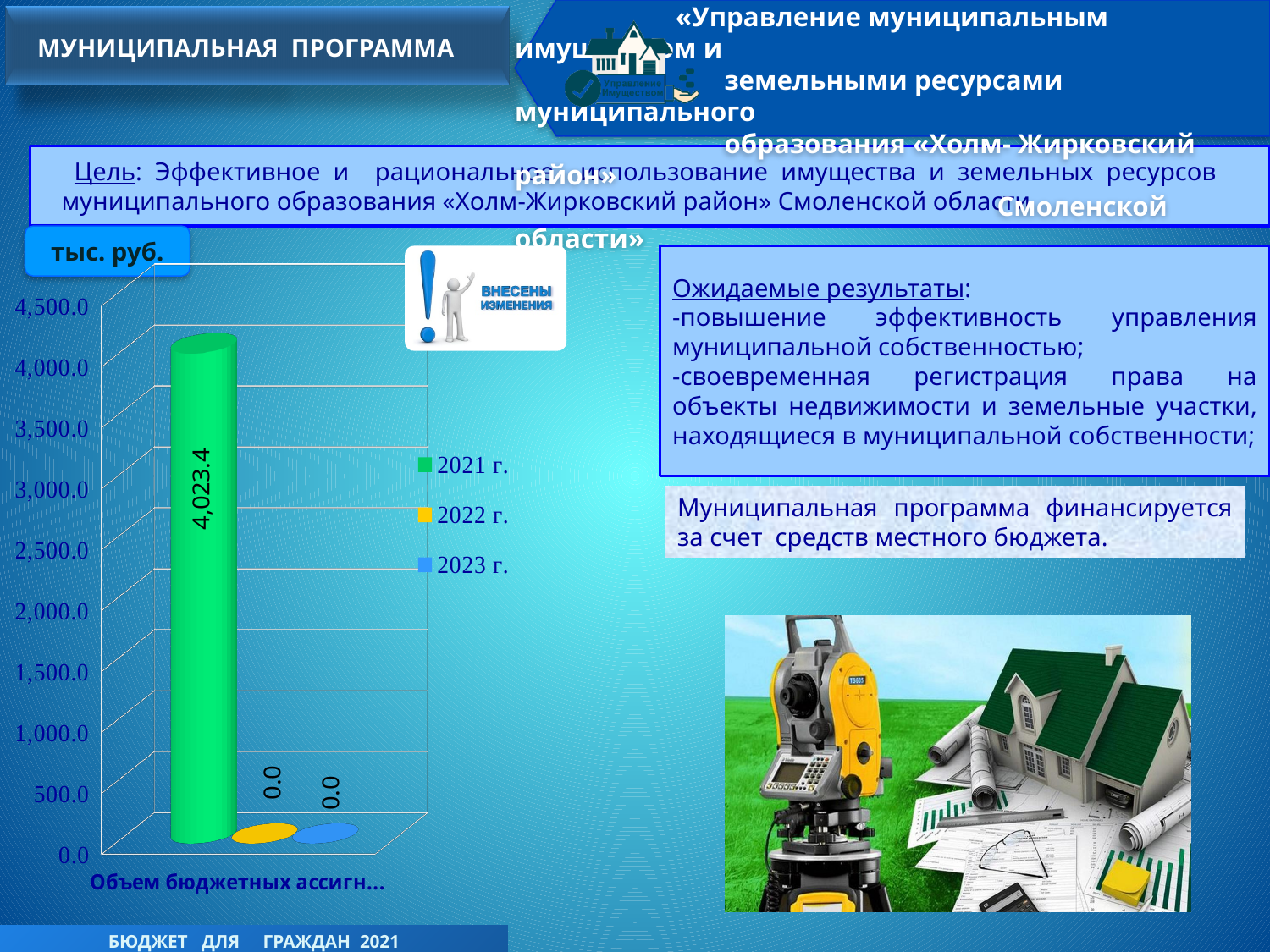
How many series does the chart legend list? 3 What is the highest value shown on the vertical axis of the chart? 4,500.0 What kind of chart is shown on the slide? bar chart What is the value for 2021 г. on the chart? 4,023.4 What is the value for 2022 г. on the chart? 0.0 Which is larger, the value for 2021 г. or the value for 2023 г.? 2021 г. What colour is the bar for 2021 г.? green What is the value for 2023 г. on the chart? 0.0 What is the difference between the values for 2021 г. and 2022 г.? 4,023.4 What unit is indicated for the chart values? тыс. руб. Is the value for 2021 г. greater or less than 4,000.0? greater Which series has the highest value on the chart? 2021 г.